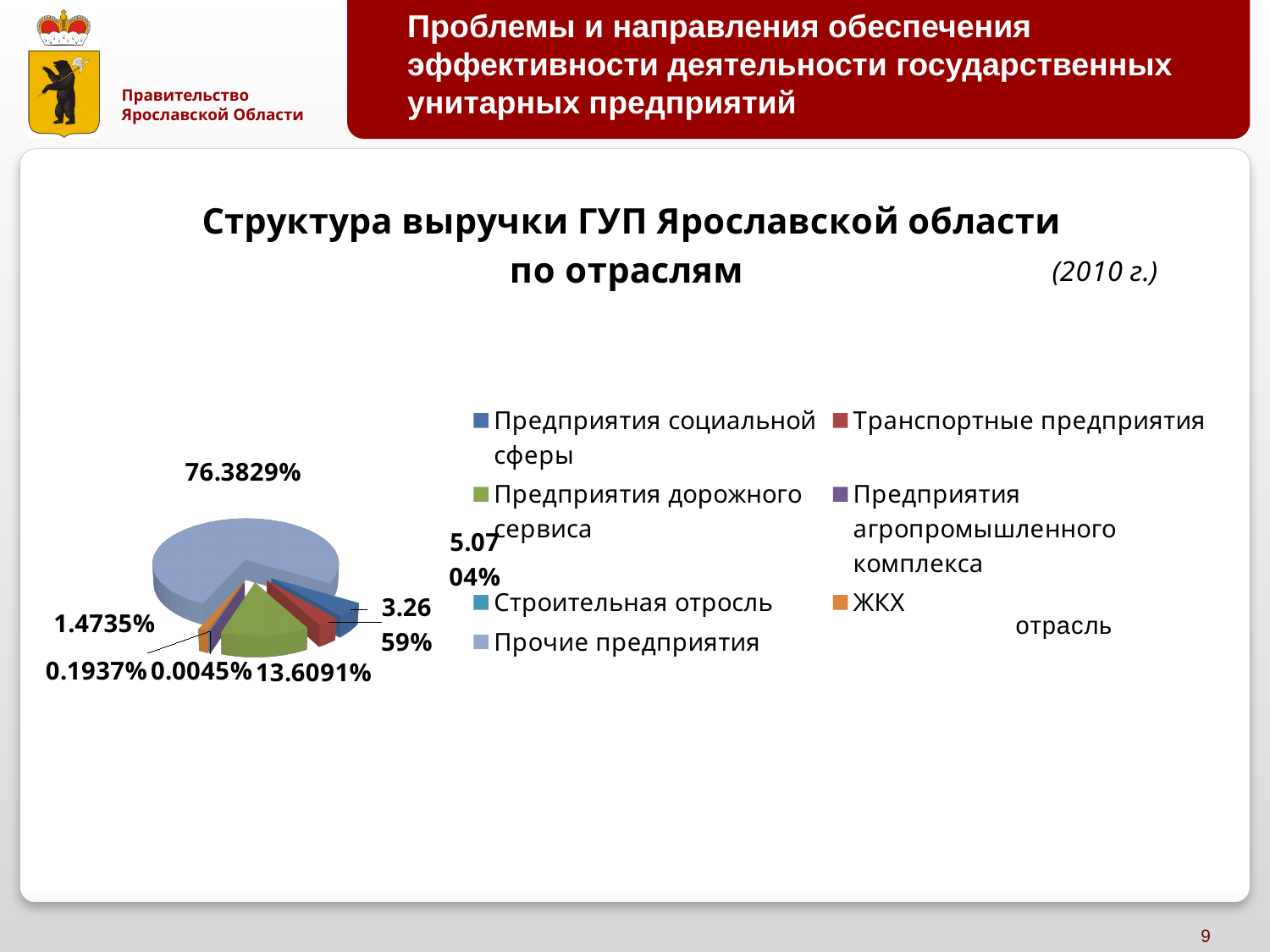
Which is larger on the pie chart: the 13.6091% slice or the 5.0704% slice? 13.6091% What is the largest share shown on the pie chart? 76.3829% What kind of chart is shown on the slide? Pie chart What is the difference between the largest share (76.3829%) and the smallest share (0.0045%) on the pie chart? 76.3784% What is the smallest share shown on the pie chart? 0.0045% Which is larger on the pie chart: the 1.4735% slice or the 0.1937% slice? 1.4735% For which year is the revenue structure shown on the slide? 2010 г. What is the difference between the 76.3829% slice and the 13.6091% slice? 62.7738% Which category has the largest slice of the pie chart? Прочие предприятия What share is shown for the green slice (Предприятия дорожного сервиса)? 13.6091% How many categories does the legend of the pie chart list? 7 What is the title of the chart on the slide? Структура выручки ГУП Ярославской области по отраслям